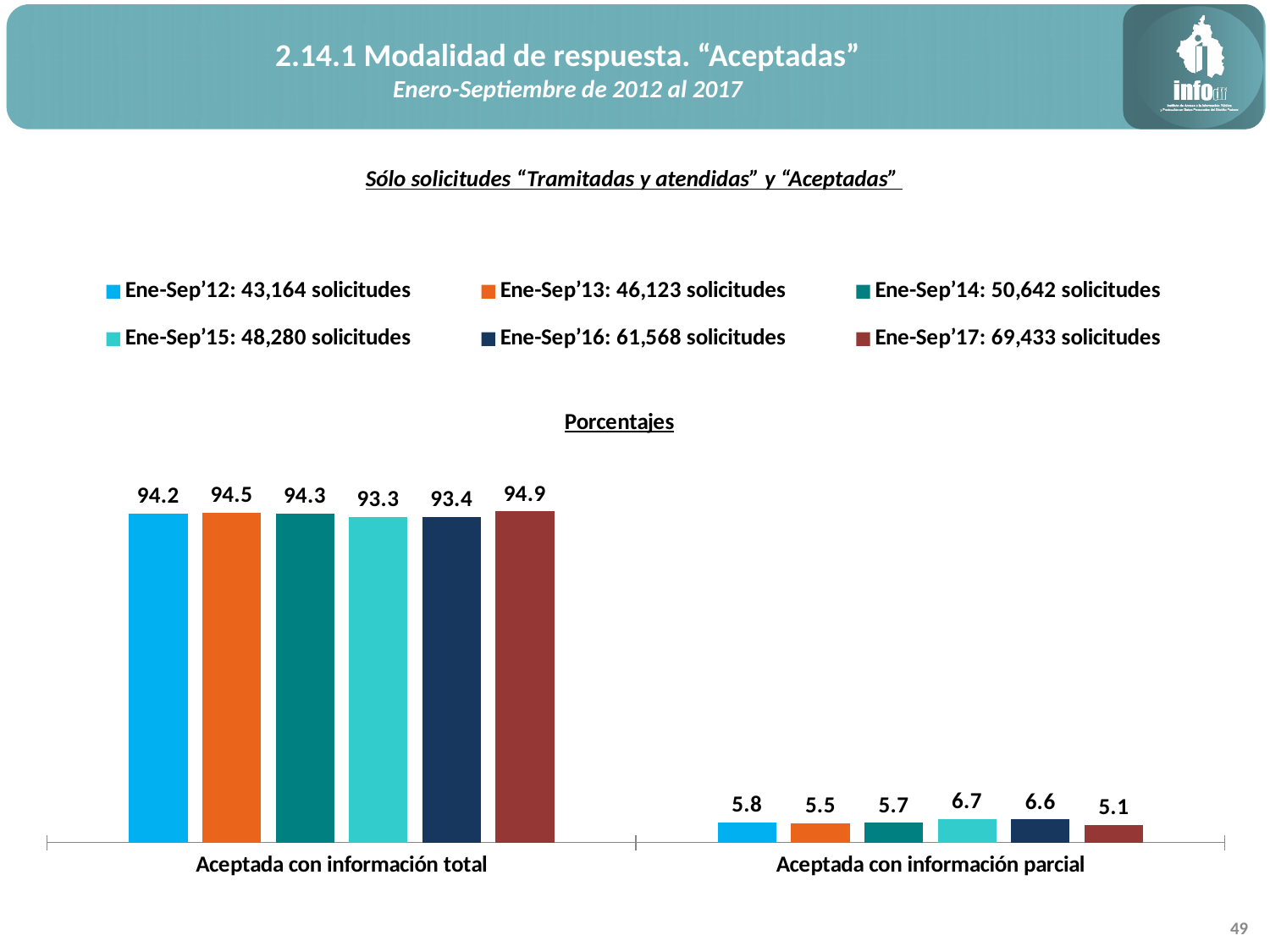
According to the legend, how many solicitudes were there in Ene-Sep'16? 61,568 Which series has the lowest value in the 'Aceptada con información parcial' category? Ene-Sep'17 What kind of chart is shown on the slide? Bar chart What is the difference between the Ene-Sep'17 and Ene-Sep'15 values in the 'Aceptada con información total' category? 1.6 What is the value for Ene-Sep'12 in the 'Aceptada con información total' category? 94.2 What is the difference between the Ene-Sep'15 and Ene-Sep'17 values in the 'Aceptada con información parcial' category? 1.6 What is the value for Ene-Sep'17 in the 'Aceptada con información parcial' category? 5.1 How many series does the legend list? 6 Which is larger in the 'Aceptada con información total' category: Ene-Sep'13 or Ene-Sep'16? Ene-Sep'13 What is the value for Ene-Sep'15 in the 'Aceptada con información parcial' category? 6.7 Which series has the highest value in the 'Aceptada con información total' category? Ene-Sep'17 How many categories are shown on the x axis? 2